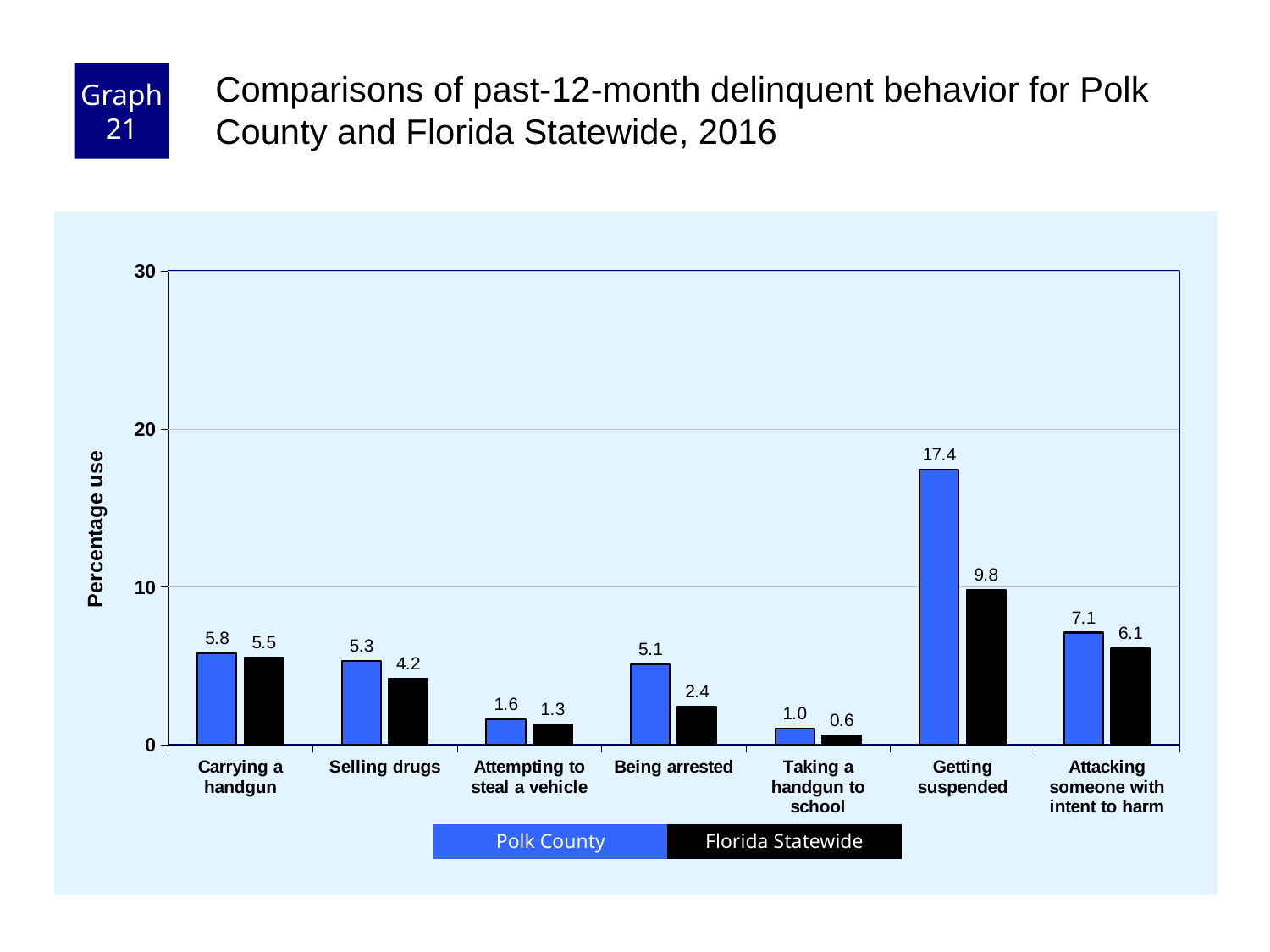
How many series does the legend list? 2 Which category has the highest Florida Statewide value? Getting suspended What kind of chart is shown on the slide? bar chart What is the Polk County value for Getting suspended? 17.4 What is the difference between the Polk County and Florida Statewide values for Getting suspended? 7.6 Which is larger for Selling drugs: the Polk County value or the Florida Statewide value? Polk County Which category has the lowest Polk County value? Taking a handgun to school How many categories are shown on the x axis? 7 What is the label of the y axis? Percentage use Is the Polk County value for Getting suspended greater or less than 20? less What is the Polk County value for Taking a handgun to school? 1.0 What is the Florida Statewide value for Being arrested? 2.4